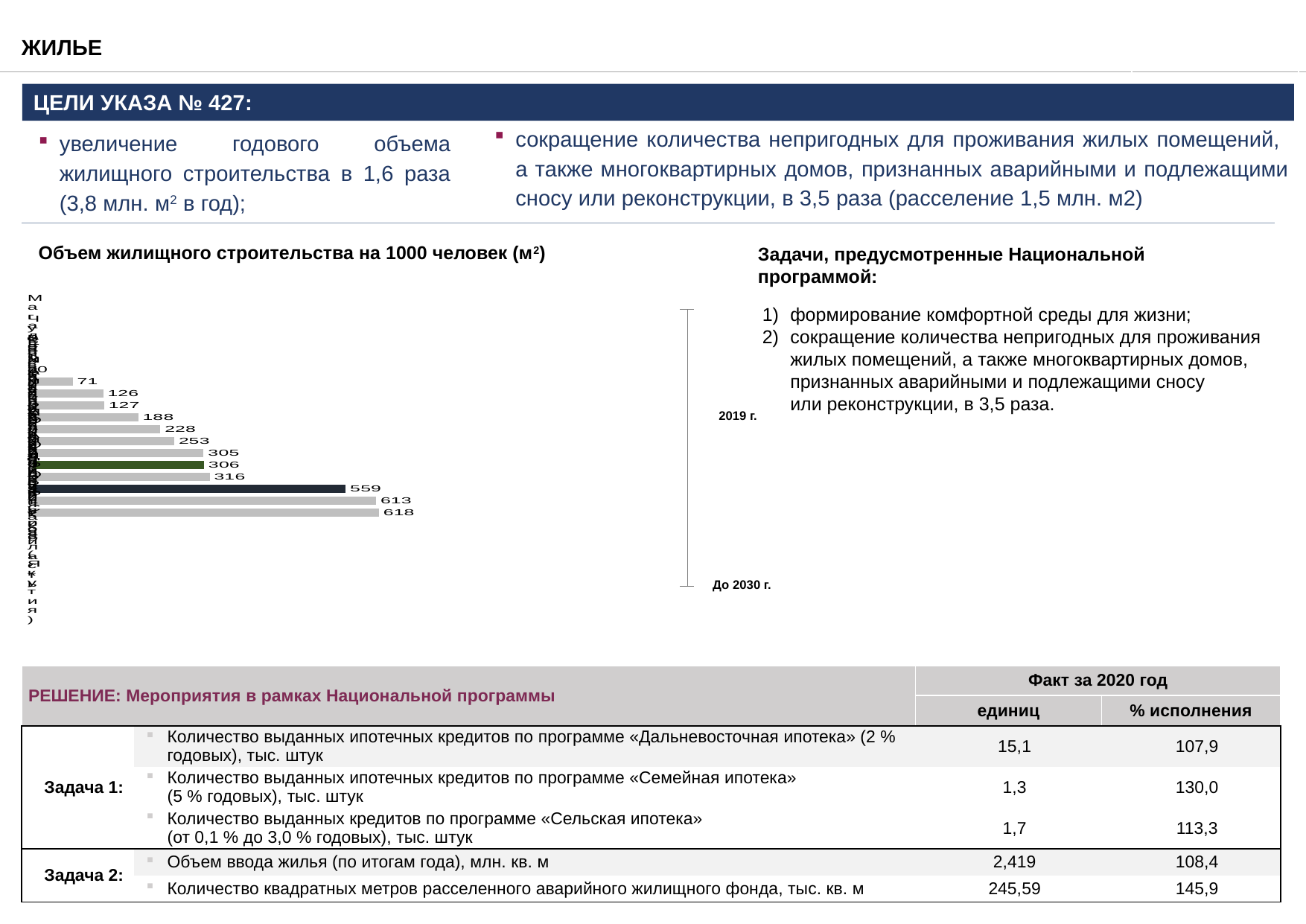
In the bar chart, what is the difference between the two longest bars, 618 and 613? 5 In the bar chart, what is the highest value shown on a data label? 618 What is the title of the bar chart on the left side of the slide? Объем жилищного строительства на 1000 человек (м²) In the bar chart, what value is labelled on the dark blue bar? 559 In the bar chart, is the value on the dark blue bar greater or less than 500? greater In the bar chart, what value is labelled on the green bar? 306 In the bar chart, how many bars have a labelled value greater than 500? 3 In the bar chart, what is the difference between the green bar (306) and the bar labelled 316? 10 In the bar chart, what is the difference between the longest bar (618) and the dark blue bar (559)? 59 In the bar chart, which is larger: the value on the green bar or the value on the dark blue bar? the dark blue bar (559) What kind of chart is shown under the title "Объем жилищного строительства на 1000 человек (м²)"? bar chart In the bar chart, what colour are most of the bars that are not highlighted? grey